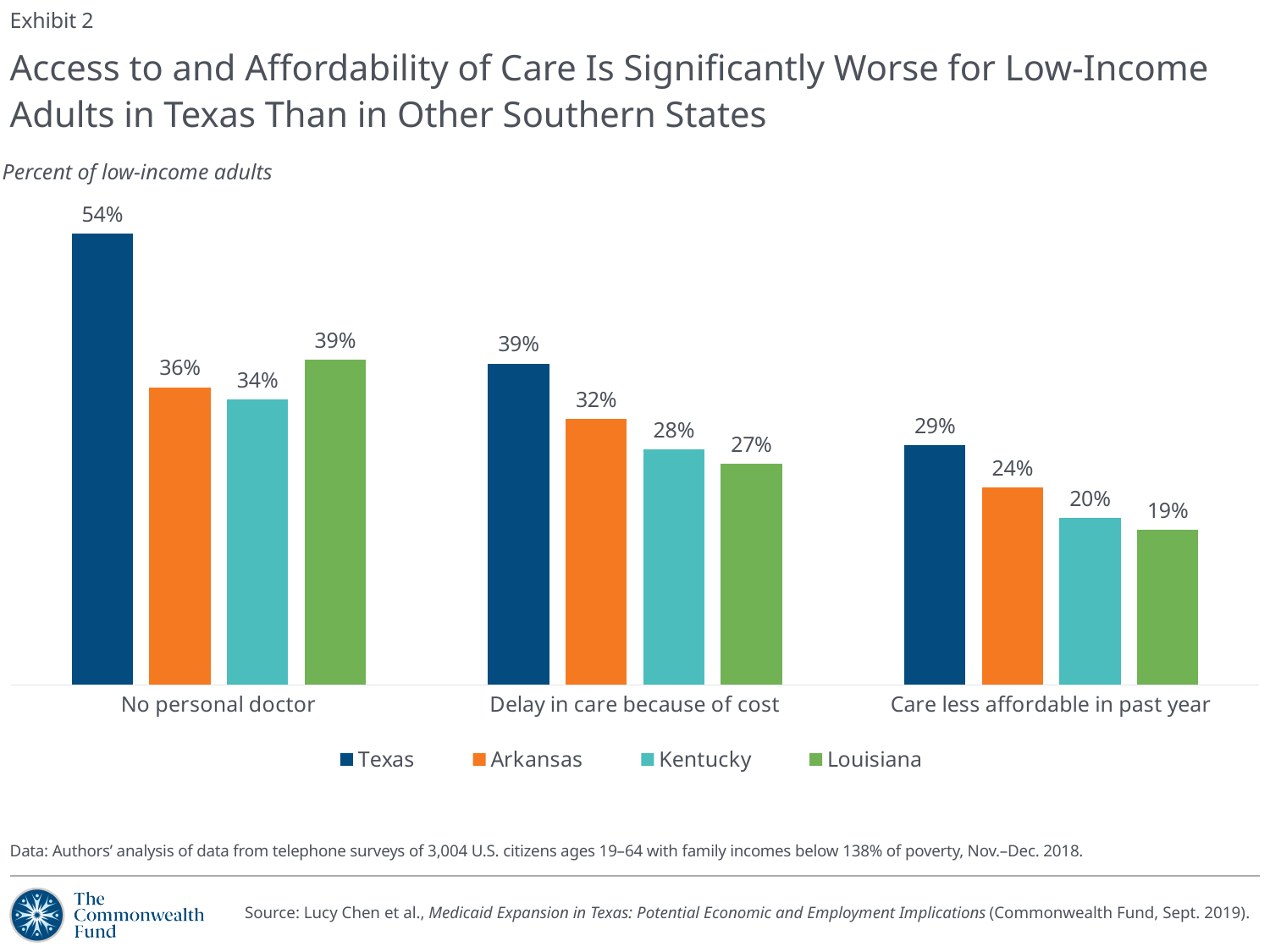
What kind of chart is shown on the slide? Bar chart Which state has the lowest value for 'Care less affordable in past year'? Louisiana What is the value for Louisiana in the 'Care less affordable in past year' category? 19% What is the difference between Texas and Arkansas for 'No personal doctor'? 18 percentage points What percent of low-income adults in Texas have no personal doctor? 54% Which state is represented by the orange bars? Arkansas What is the difference between Texas and Louisiana for 'Delay in care because of cost'? 12 percentage points Which state has the highest value for 'No personal doctor'? Texas Which is larger for 'No personal doctor': Arkansas or Louisiana? Louisiana How many categories are shown on the x axis? 3 What is the value for Kentucky in the 'Delay in care because of cost' category? 28% How many series does the legend list? 4